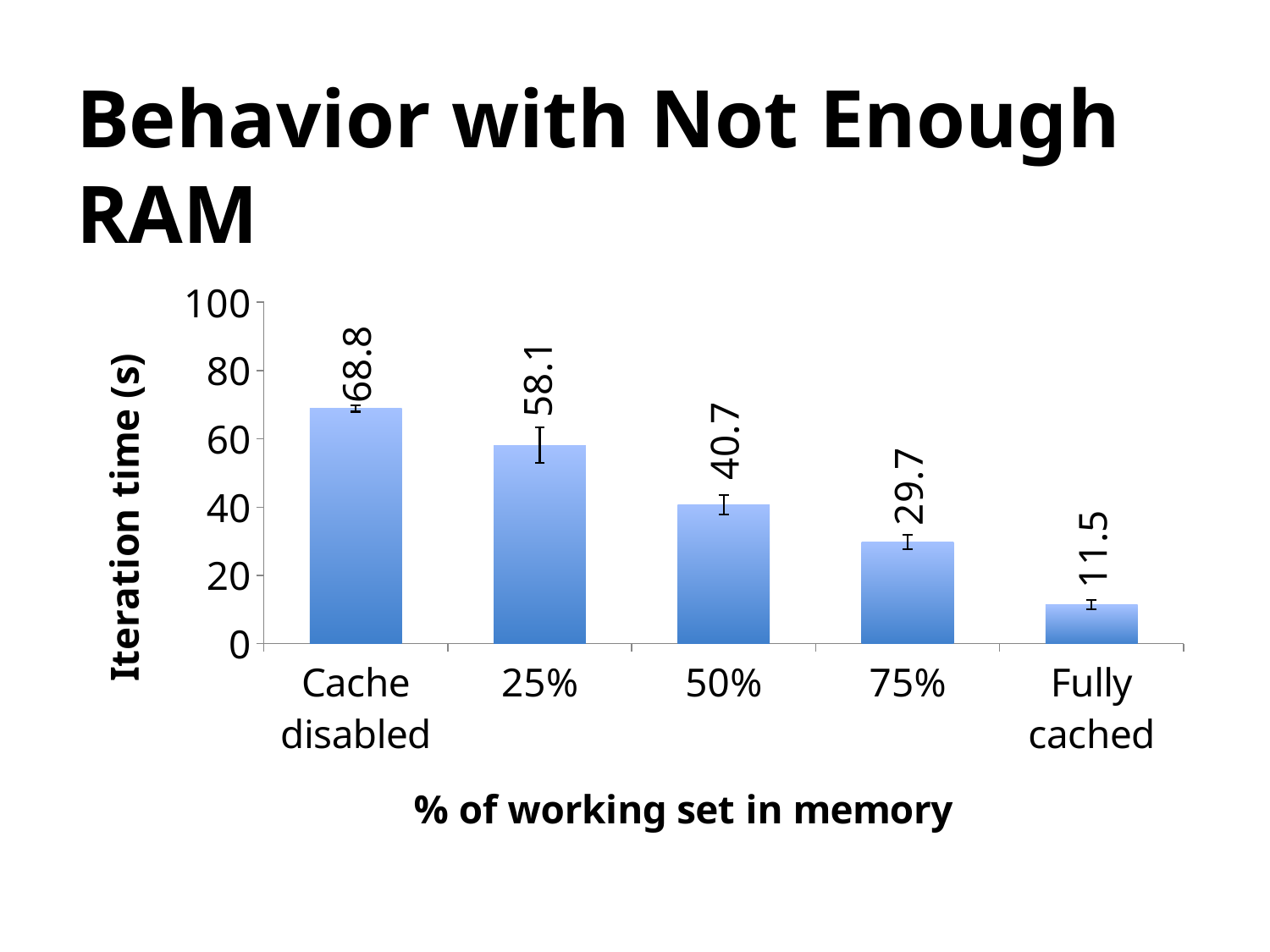
Which has a larger iteration time, 25% or 50%? 25% What is the difference in iteration time between 25% and 75%? 28.4 How many categories are shown on the x axis? 5 Is the iteration time for 75% greater or less than 40? less What is the iteration time for 'Cache disabled'? 68.8 What kind of chart is shown on the slide? Bar chart What is the iteration time when 50% of the working set is in memory? 40.7 What is the iteration time for 'Fully cached'? 11.5 Which category has the highest iteration time? Cache disabled Which category has the lowest iteration time? Fully cached Do the iteration times rise or fall from left to right along the x axis? Fall What is the difference in iteration time between 'Cache disabled' and 'Fully cached'? 57.3